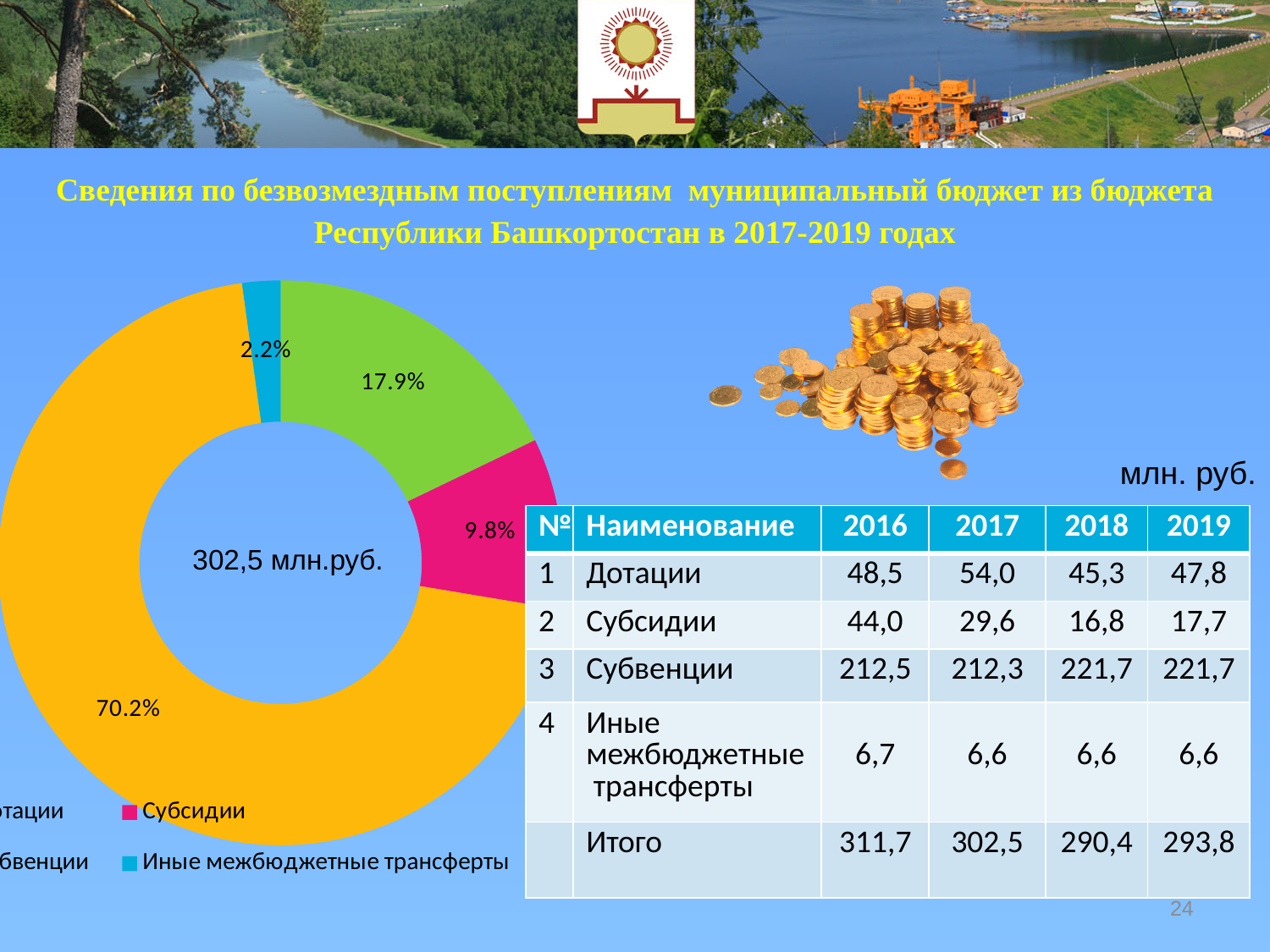
What value is printed in the centre of the doughnut chart? 302,5 млн.руб. How many entries does the chart legend list? 4 How many slices does the doughnut chart have? 4 Which category has the smallest slice in the doughnut chart? Иные межбюджетные трансферты Is the largest slice of the doughnut chart greater or less than 50%? greater What percentage does the chart show for Субсидии? 9.8% What is the largest percentage shown on the doughnut chart? 70.2% What percentage does the chart show for Иные межбюджетные трансферты? 2.2% What kind of chart is shown on the left of the slide? pie (doughnut) chart Which slice is larger, Субсидии or Иные межбюджетные трансферты? Субсидии What is the difference in percentage points between the green slice (17.9%) and the Субсидии slice (9.8%)? 8.1 What colour represents Субсидии in the doughnut chart? pink